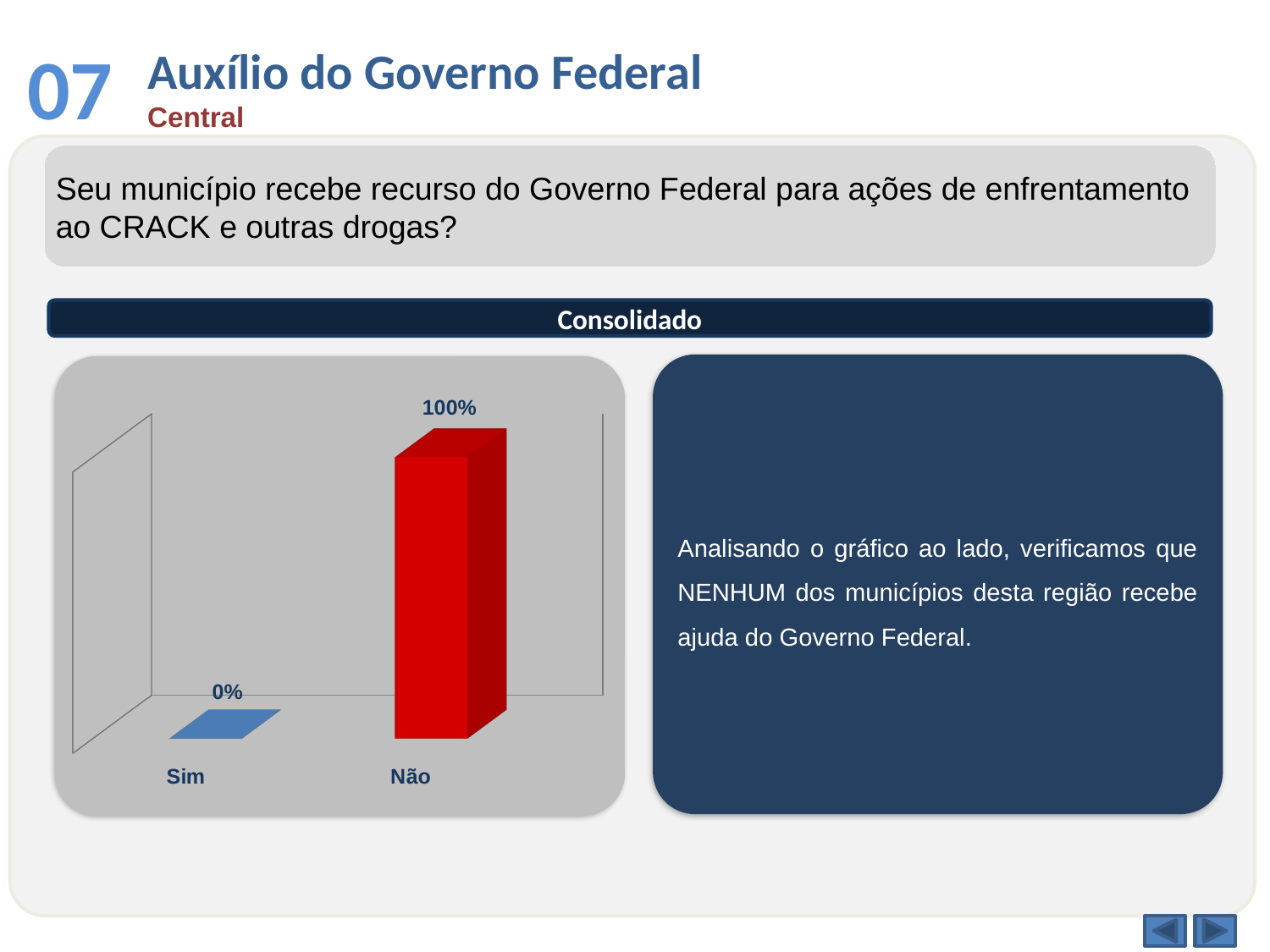
What is the difference between the values for Não and Sim? 100% What colour is the bar for Não? Red What kind of chart is shown on the slide? Bar chart What colour is the bar for Sim? Blue Which category has the highest value? Não Which is larger, the value for Sim or the value for Não? Não How many categories are shown in the chart? 2 What is the value for Sim? 0% Which category has the lowest value? Sim What is the value for Não? 100%